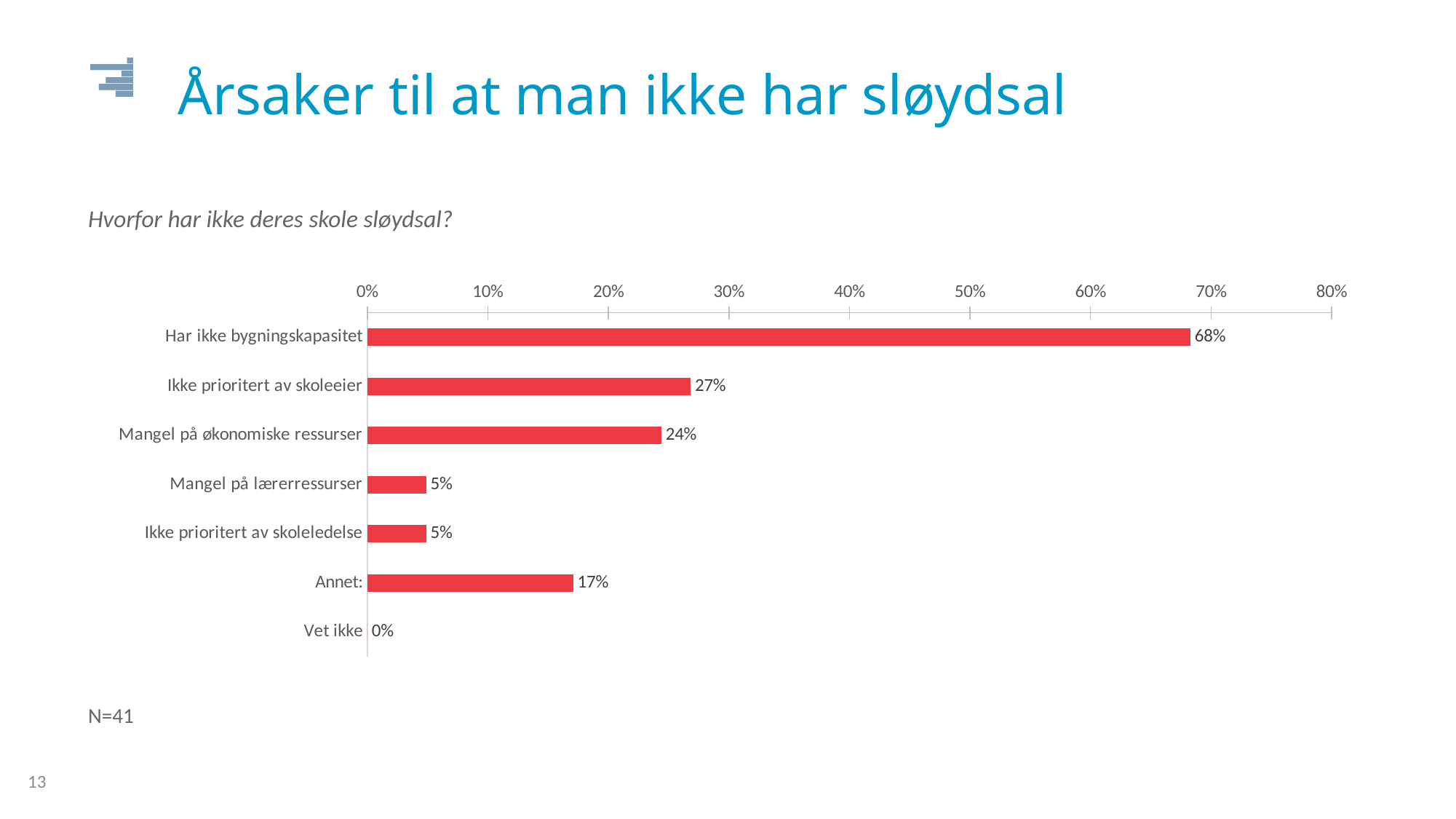
What is the sample size (N) stated below the chart? N=41 What kind of chart is shown on the slide? Bar chart What is the value for "Mangel på økonomiske ressurser"? 24% How many categories are shown in the chart? 7 Which category has the highest value? Har ikke bygningskapasitet What is the value for "Ikke prioritert av skoleeier"? 27% What is the value for "Har ikke bygningskapasitet"? 68% What is the value for "Annet:"? 17% What is the difference between "Har ikke bygningskapasitet" and "Ikke prioritert av skoleeier"? 41% Which category has the lowest value? Vet ikke What is the value for "Vet ikke"? 0% Which is larger, "Mangel på økonomiske ressurser" or "Annet:"? Mangel på økonomiske ressurser